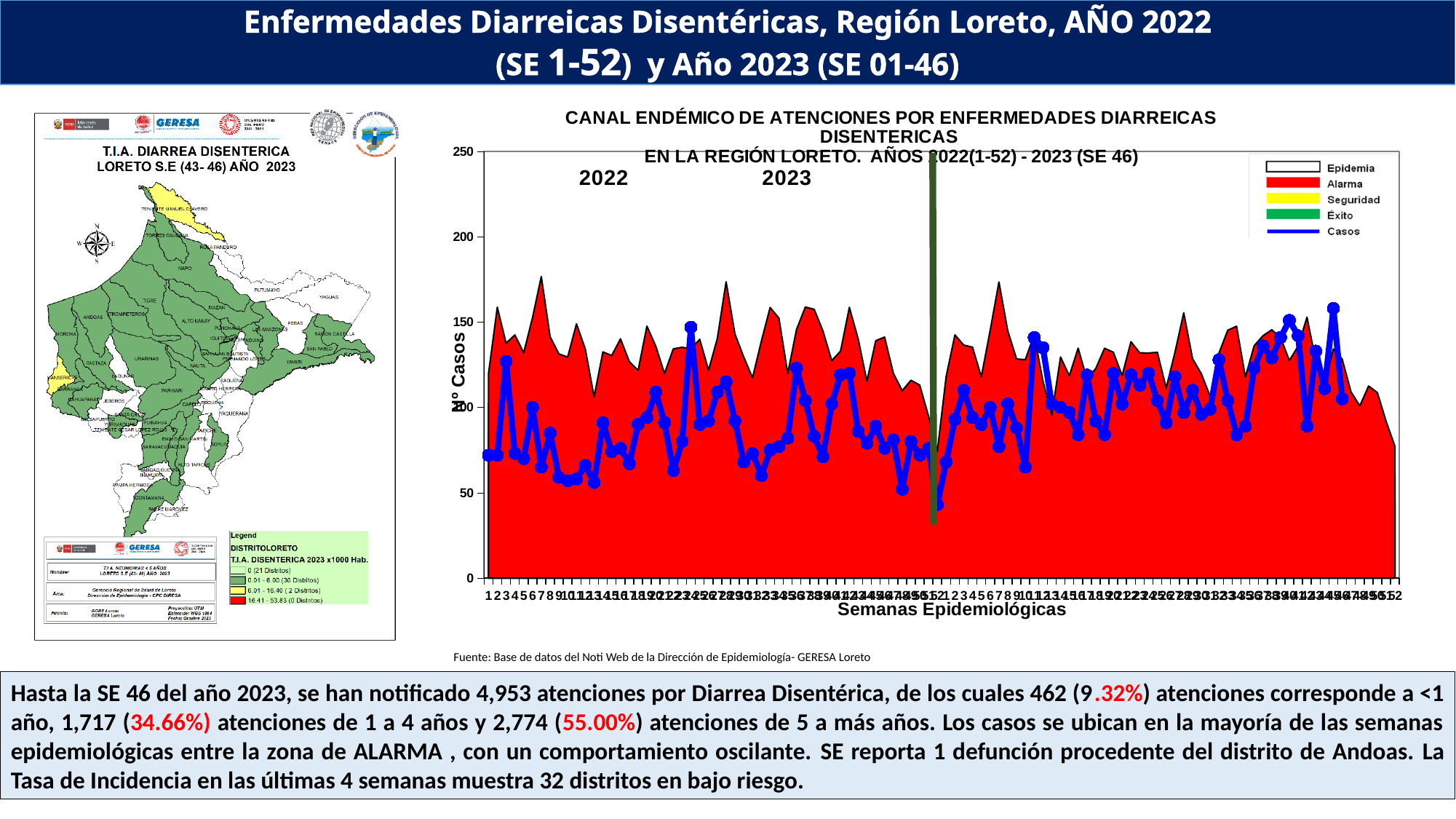
What kind of chart is the 'CANAL ENDÉMICO DE ATENCIONES' chart? A combined area and line chart How many years are plotted along the x axis of the endemic channel chart? 2 In the endemic channel chart, do the Casos values generally rise or fall across the weeks of 2023? rise In the endemic channel chart, which is larger: the Casos value for week 1 of 2023 or for week 46 of 2023? Week 46 of 2023 In the endemic channel chart, is the Casos value for week 23 of 2022 greater or less than 100? less In the endemic channel chart, is the Casos value for week 1 of 2022 greater or less than 100? less How many entries does the legend of the endemic channel chart list? 5 In the endemic channel chart, which colour represents the 'Alarma' zone? Red In the endemic channel chart, is the Casos value for week 1 of 2023 greater or less than 100? less In the endemic channel chart, which is larger: the Casos value for week 10 of 2022 or for week 23 of 2022? Week 23 of 2022 In the endemic channel chart, which legend entry is drawn as a blue line? Casos